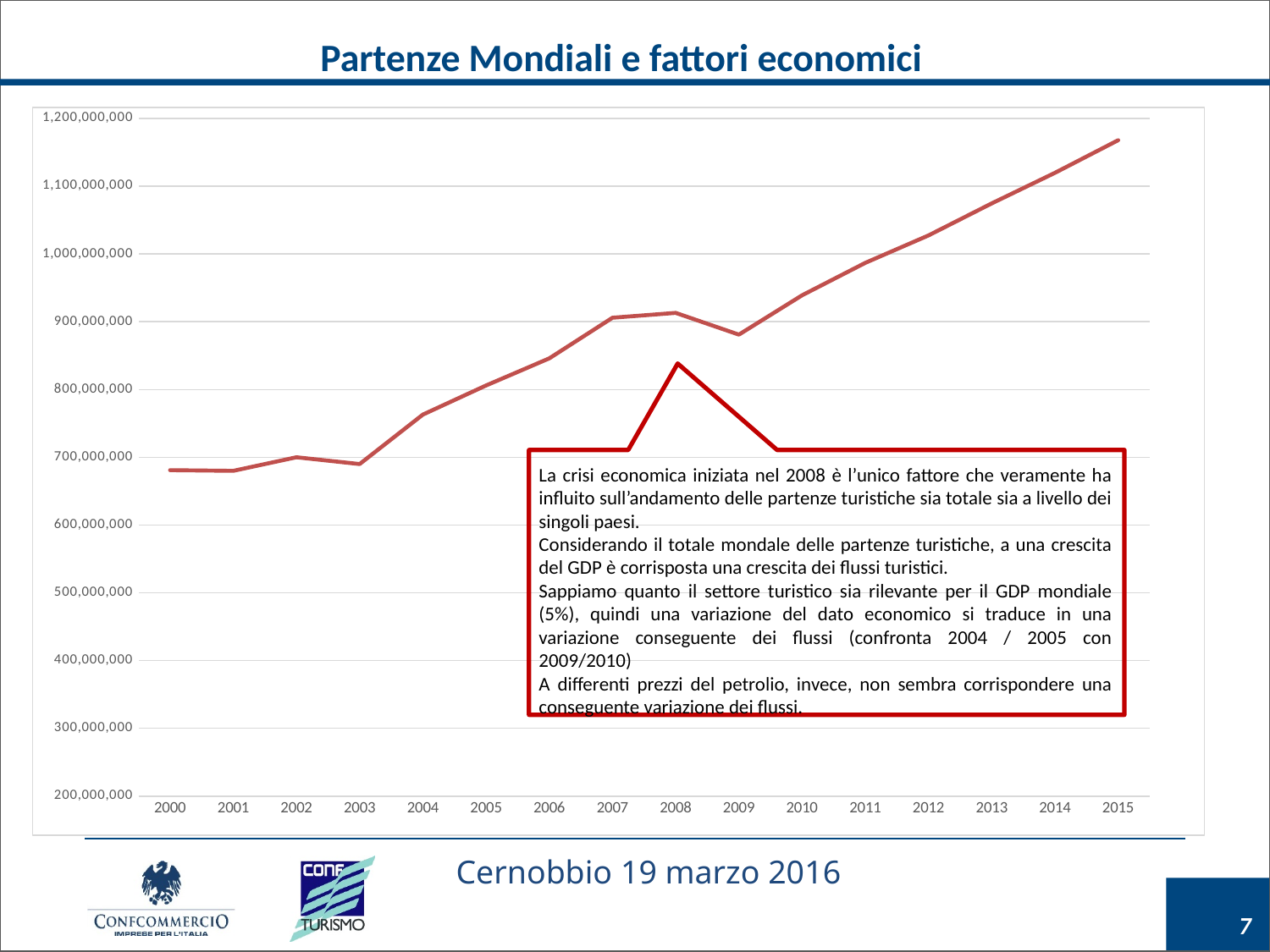
Which year has the highest value on the chart? 2015 Which year has the larger value, 2008 or 2009? 2008 Overall, do the values rise or fall from 2000 to 2015? rise How many years are plotted along the x axis of the chart? 16 Is the value for 2004 greater or less than 800,000,000? less Is the value for 2000 greater or less than 700,000,000? less What kind of chart is shown on the slide? line chart What colour is the line plotted on the chart? red Which year has the larger value, 2005 or 2007? 2007 Is the value for 2012 greater or less than 1,000,000,000? greater